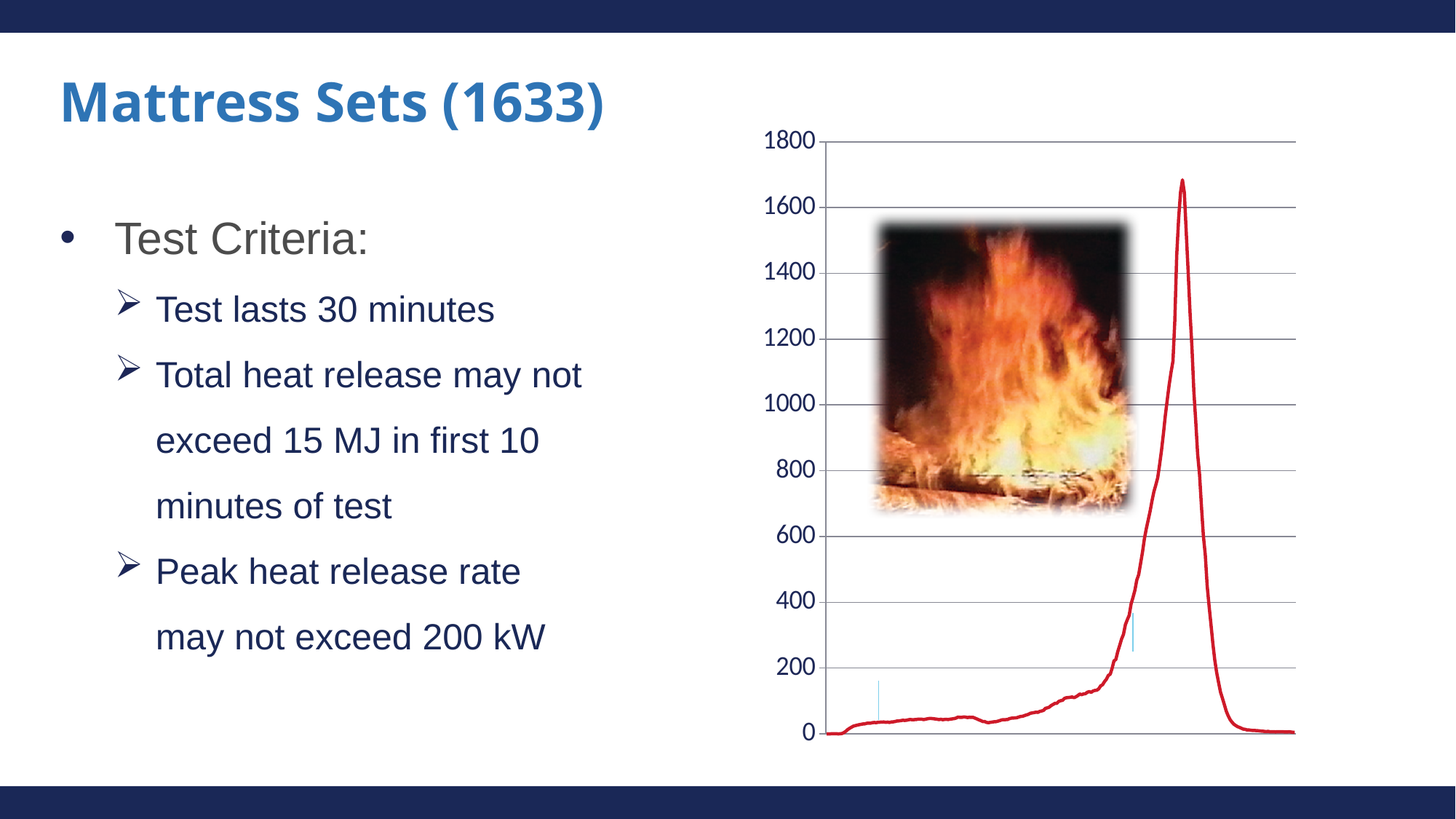
Is the value of the red line at the far right end of the chart greater or less than 200? less Is the peak value of the red line greater or less than 1600? greater Is the peak value of the red line greater or less than 1800? less What kind of chart is shown on the right of the slide? line chart What is the lowest value labelled on the vertical axis of the chart? 0 Does the red line rise or fall immediately after reaching its peak? fall Does the red line rise or fall between the start of the chart and its peak? rise How many lines are plotted on the chart? 1 What is the highest value labelled on the vertical axis of the chart? 1800